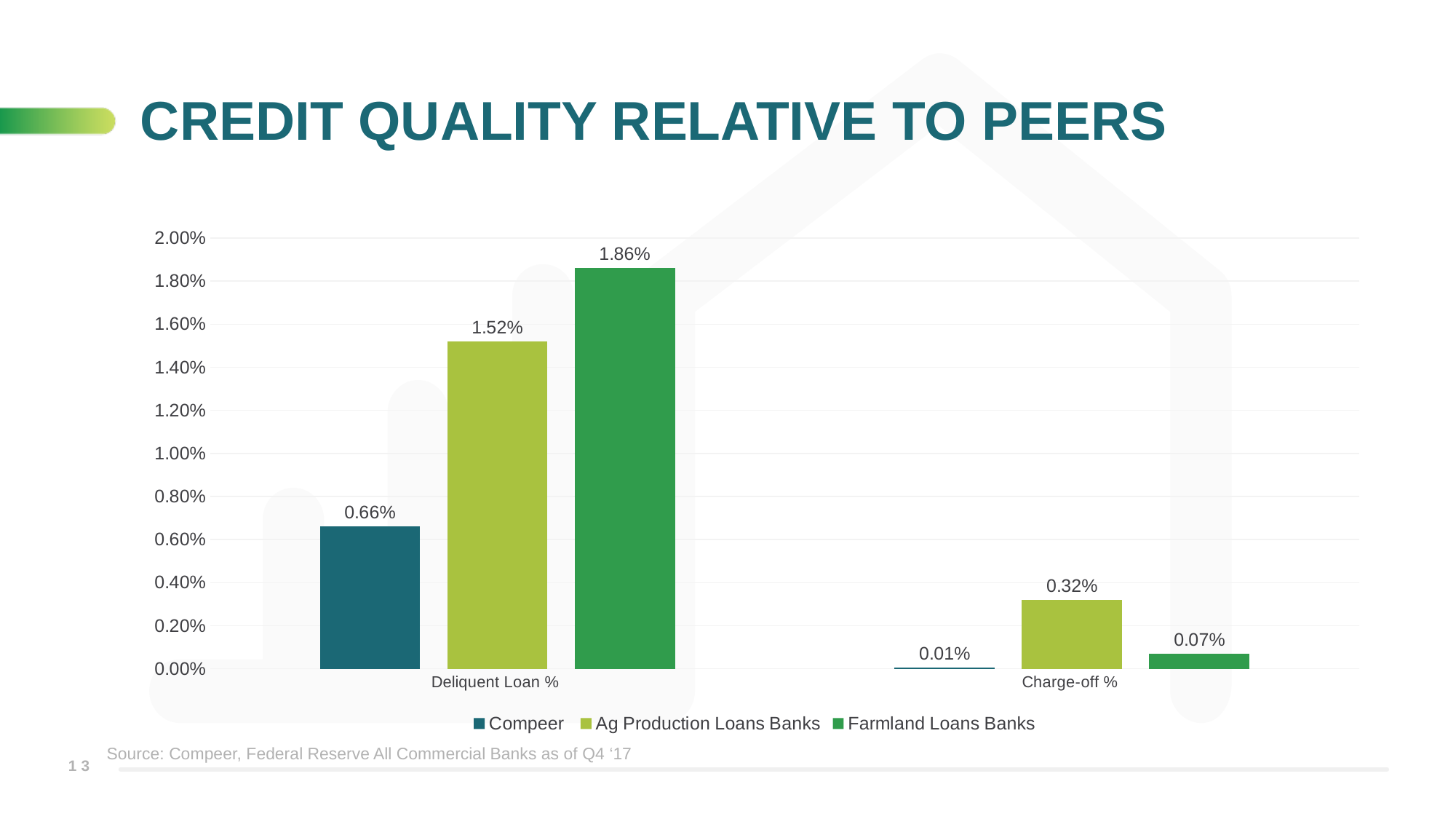
Which is larger: the Charge-off % for Farmland Loans Banks or for Ag Production Loans Banks? Ag Production Loans Banks Which series has the lowest Charge-off %? Compeer What is the Deliquent Loan % value for Compeer? 0.66% What is the Deliquent Loan % value for Farmland Loans Banks? 1.86% How many series does the legend list? 3 What is the title of the slide containing the chart? CREDIT QUALITY RELATIVE TO PEERS What is the difference between the Deliquent Loan % for Ag Production Loans Banks and Compeer? 0.86% Which series has the highest Deliquent Loan %? Farmland Loans Banks What is the Charge-off % value for Compeer? 0.01% What kind of chart is shown on the slide? Bar chart Is the Deliquent Loan % for Ag Production Loans Banks greater or less than 1.40%? greater What is the Charge-off % value for Ag Production Loans Banks? 0.32%